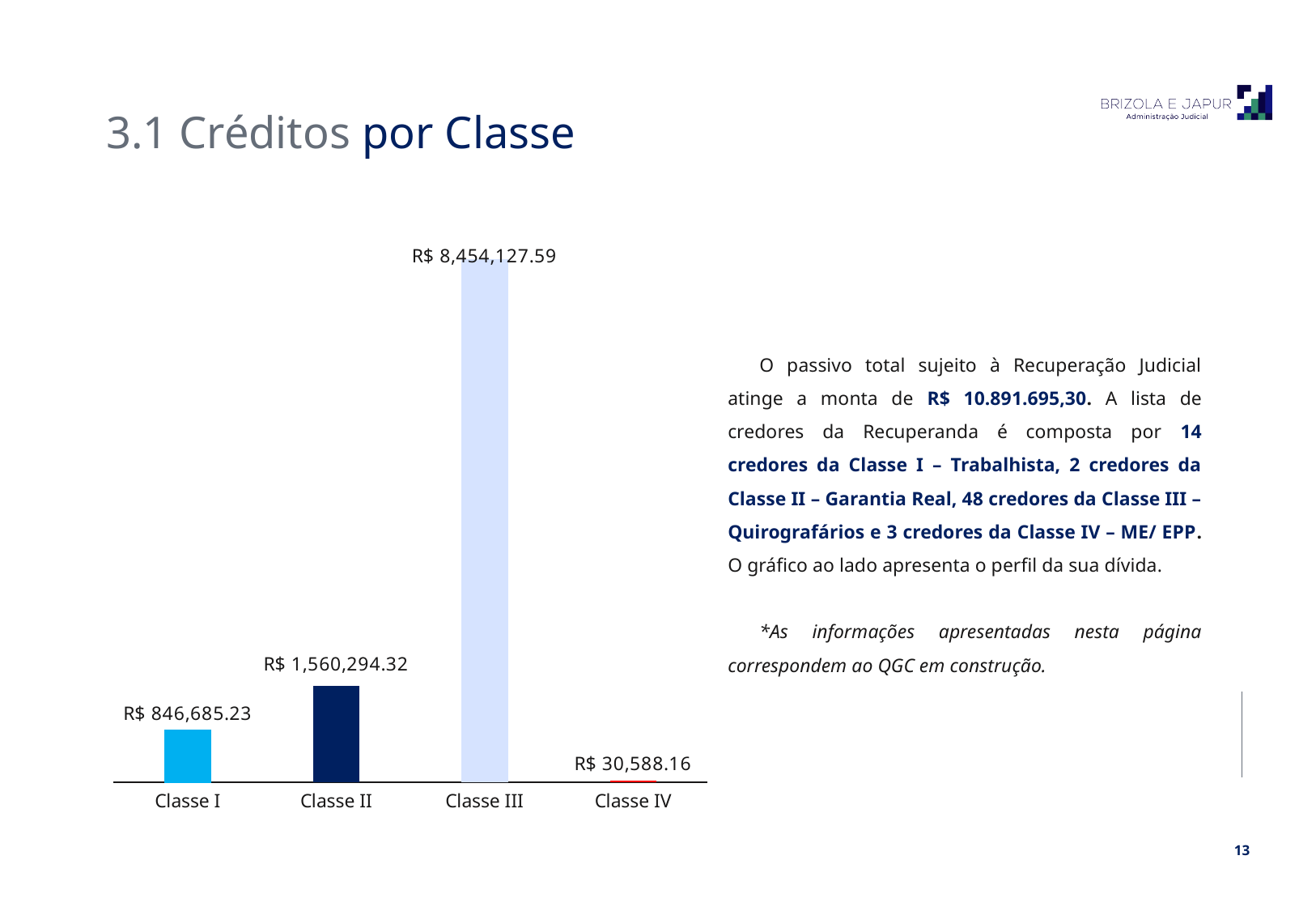
What is the value shown for Classe IV? R$ 30,588.16 What colour is the bar for Classe IV? Red What is the difference between the values for Classe II and Classe I? R$ 713,609.09 How many classes are shown in the chart? 4 Which class has the lowest value in the chart? Classe IV What is the value shown for Classe III? R$ 8,454,127.59 Which class has the highest value in the chart? Classe III What kind of chart is shown on the slide? Bar chart What is the difference between the values for Classe III and Classe II? R$ 6,893,833.27 Which is larger, the value for Classe I or the value for Classe II? Classe II What is the value shown for Classe II? R$ 1,560,294.32 What is the value shown for Classe I? R$ 846,685.23